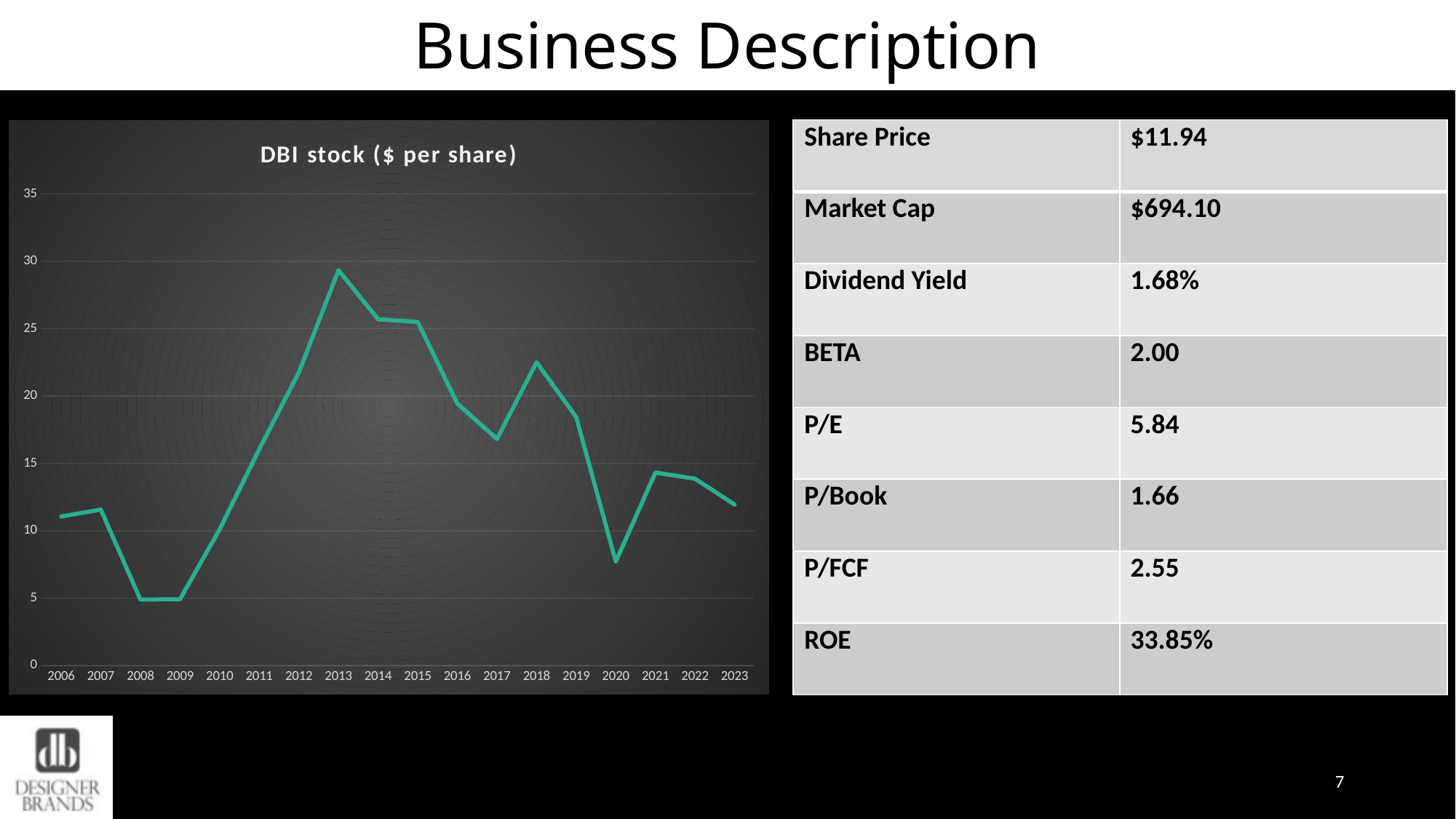
Is the value for 2013 greater or less than 25? greater What is the title of the chart on the slide? DBI stock ($ per share) Which year has the higher stock price, 2013 or 2018? 2013 Which year has the higher stock price, 2020 or 2021? 2021 What kind of chart is shown on the slide? line chart Does the stock price rise or fall from 2013 to 2017? fall How many years are plotted on the x axis of the chart? 18 Is the value for 2018 greater or less than 20? greater In which year does the DBI stock price reach its highest point on the chart? 2013 Is the value for 2020 greater or less than 10? less Does the stock price rise or fall from 2009 to 2013? rise